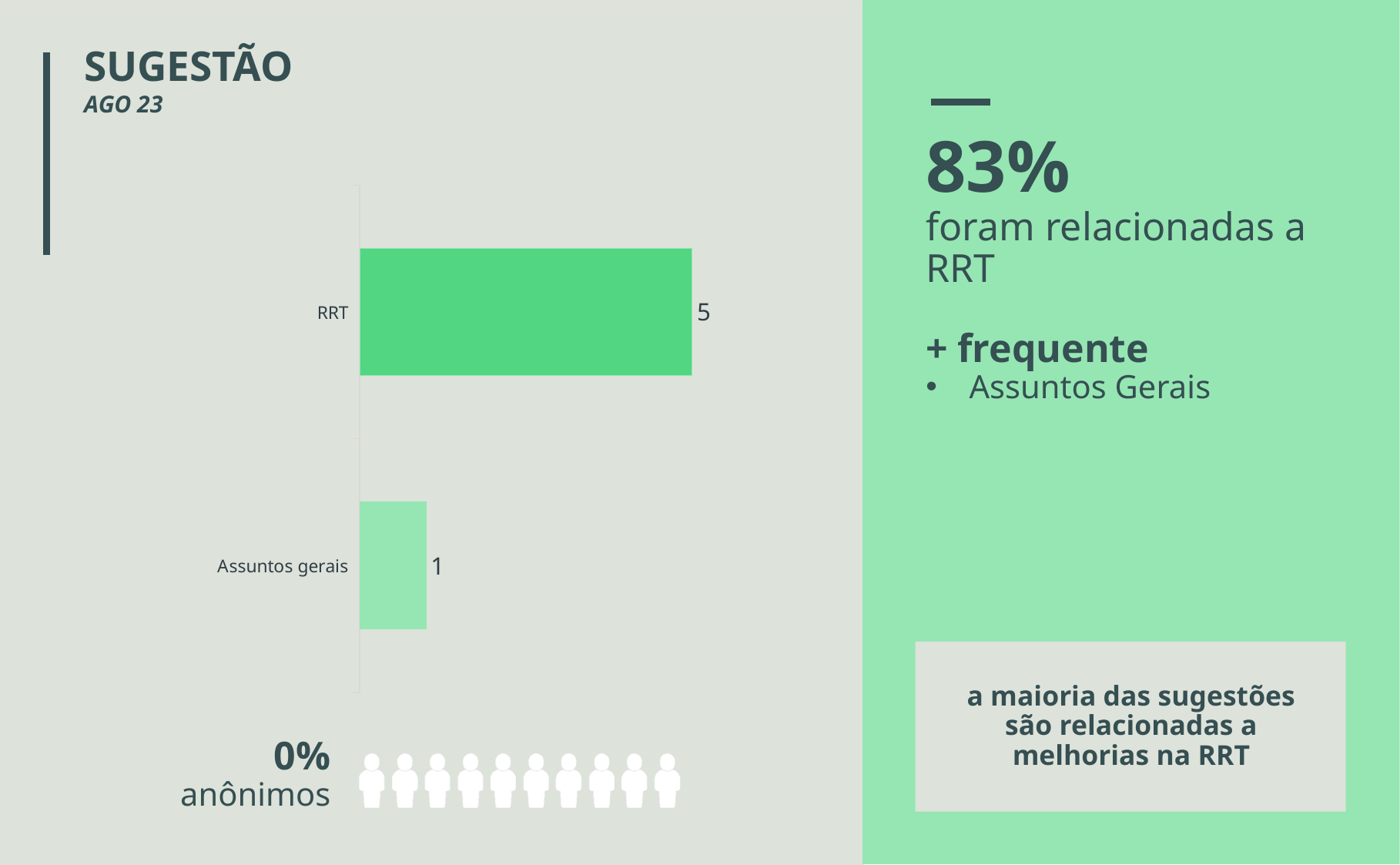
What kind of chart is shown on the slide? Bar chart Which category has the lowest value? Assuntos gerais What is the value for RRT? 5 What is the title of the slide containing the chart? SUGESTÃO What is the total of the values for RRT and Assuntos gerais? 6 Which is larger, the value for RRT or the value for Assuntos gerais? RRT Are the bars in the chart horizontal or vertical? Horizontal What is the value for Assuntos gerais? 1 How many categories are shown in the bar chart? 2 Which category has the highest value? RRT What is the difference between the values for RRT and Assuntos gerais? 4